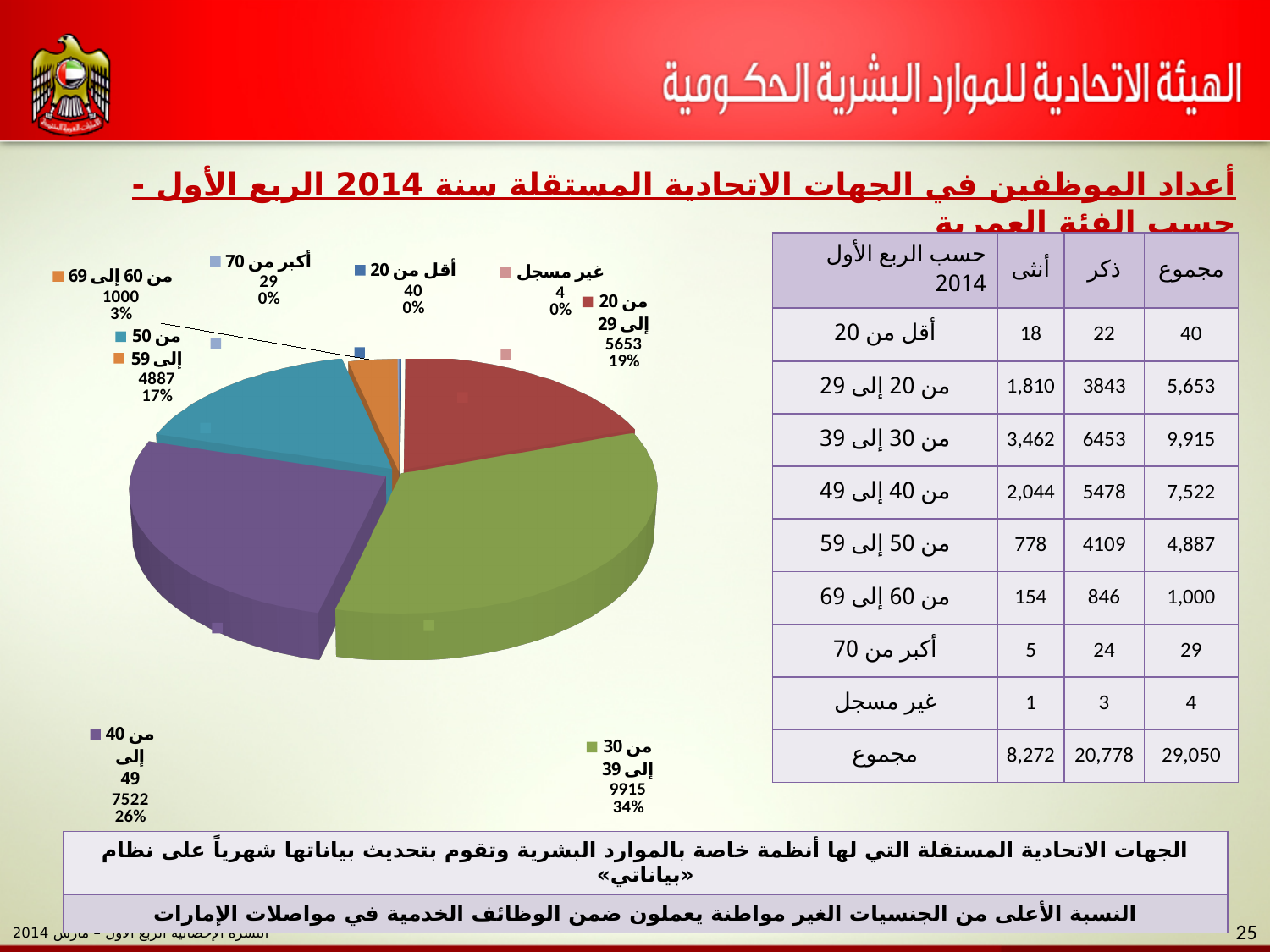
What is the difference between the values for "من 30 إلى 39" and "من 40 إلى 49" in the pie chart? 2393 Which age category has the largest slice in the pie chart? من 30 إلى 39 What is the value shown for the slice "من 30 إلى 39" in the pie chart? 9915 What percentage share does the slice "من 60 إلى 69" have in the pie chart? 3% Which age category has the smallest slice in the pie chart? غير مسجل What is the value shown for the slice "أكبر من 70" in the pie chart? 29 How many slices (age categories) does the pie chart have? 8 Which is larger in the pie chart: the value for "من 50 إلى 59" or the value for "من 60 إلى 69"? من 50 إلى 59 What percentage share does the slice "من 50 إلى 59" have in the pie chart? 17% What kind of chart is shown on the slide? pie chart What percentage share does the slice "من 40 إلى 49" have in the pie chart? 26% What is the value shown for the slice "من 20 إلى 29" in the pie chart? 5653